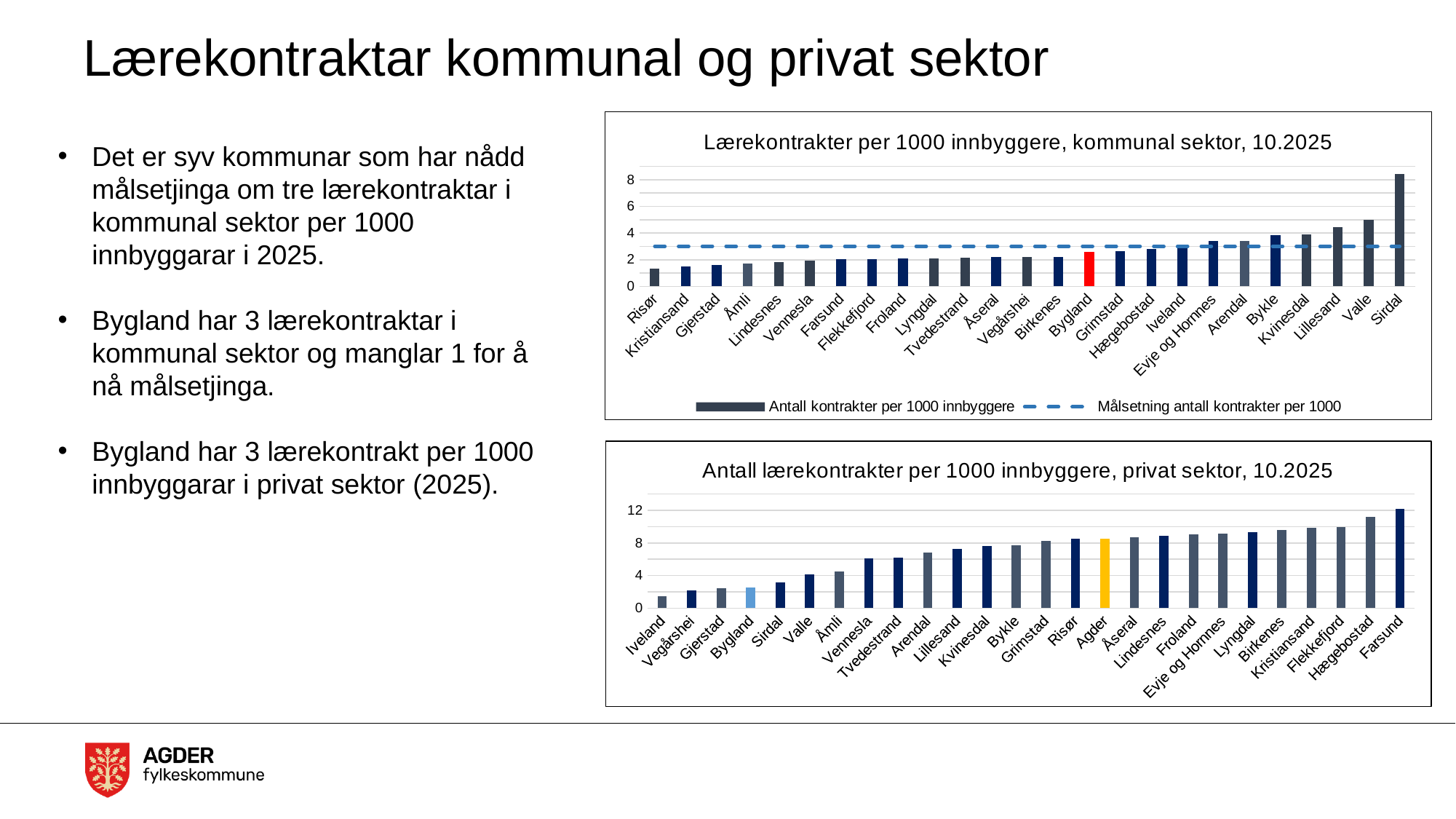
In the top chart (kommunal sektor), which is larger, the value for Sirdal or the value for Valle? Sirdal What kind of chart is the bottom chart (privat sektor)? Bar chart In the top chart (kommunal sektor), which municipality has the lowest value? Risør In the top chart (kommunal sektor), is the value for Kristiansand greater or less than 2? less In the bottom chart (privat sektor), which municipality has the highest value? Farsund In the top chart (kommunal sektor), is the value for Sirdal greater or less than 8? greater In the bottom chart (privat sektor), is the value for Hægebostad greater or less than 8? greater In the top chart (kommunal sektor), how many series does the legend list? 2 In the bottom chart (privat sektor), which municipality has the lowest value? Iveland In the top chart (kommunal sektor), which municipality has the highest number of lærekontrakter per 1000 innbyggere? Sirdal In the top chart (kommunal sektor), what colour is the bar for Bygland? Red In the bottom chart (privat sektor), do the values rise or fall from left to right along the x axis? Rise